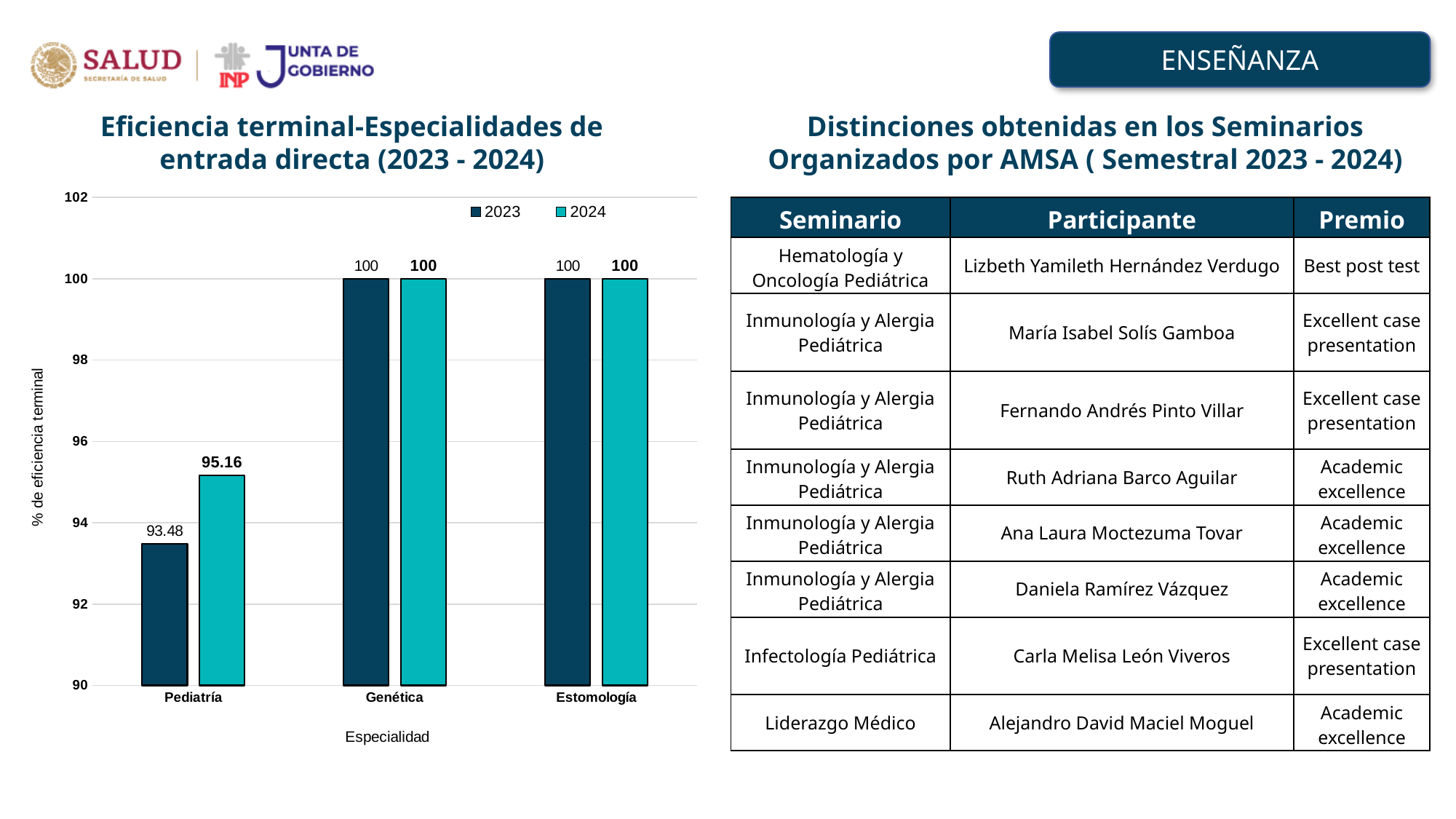
Is the 2024 value for Pediatría greater or less than 96? less What is the 2024 value for Estomología? 100 What is the difference between the 2024 and 2023 values for Pediatría? 1.68 What is the label of the chart's y axis? % de eficiencia terminal What is the 2023 value for Pediatría? 93.48 What is the 2024 value for Pediatría? 95.16 Which is larger for Pediatría, the 2023 value or the 2024 value? 2024 Which specialty has the lowest 2023 value? Pediatría How many series does the chart legend list? 2 What kind of chart is shown on the slide? bar chart How many specialties are shown on the x axis of the chart? 3 What is the 2023 value for Genética? 100